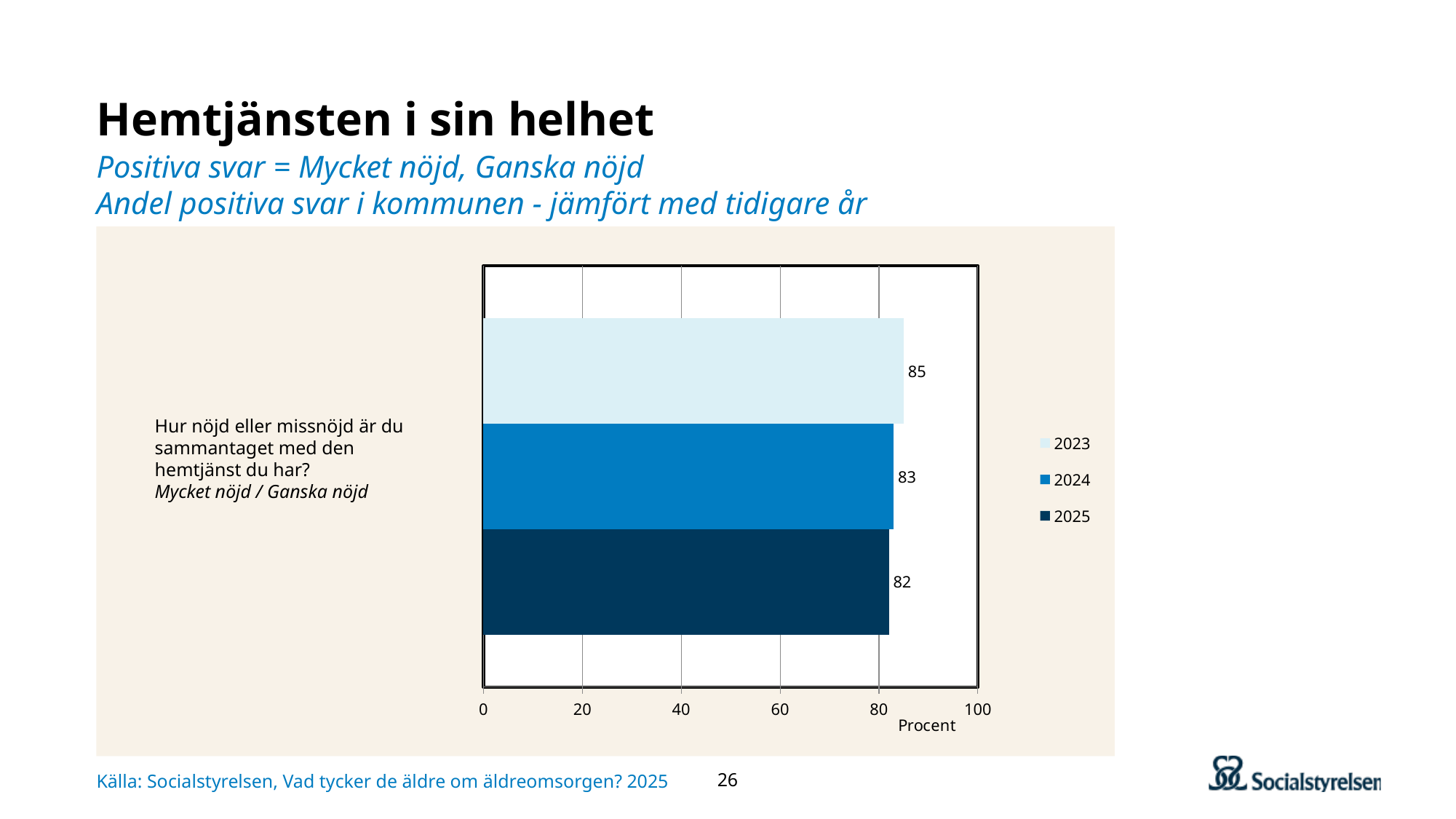
How many series does the legend list? 3 Is the value for 2025 greater or less than 80? greater What is the value for 2025? 82 What is the value for 2023? 85 What is the difference between the values for 2023 and 2025? 3 Which year has the lowest value? 2025 What kind of chart is shown on the slide? bar chart What is the value for 2024? 83 What is the difference between the values for 2024 and 2025? 1 Which year has the highest value? 2023 What is the label on the horizontal axis? Procent Which is larger, the value for 2023 or the value for 2024? 2023